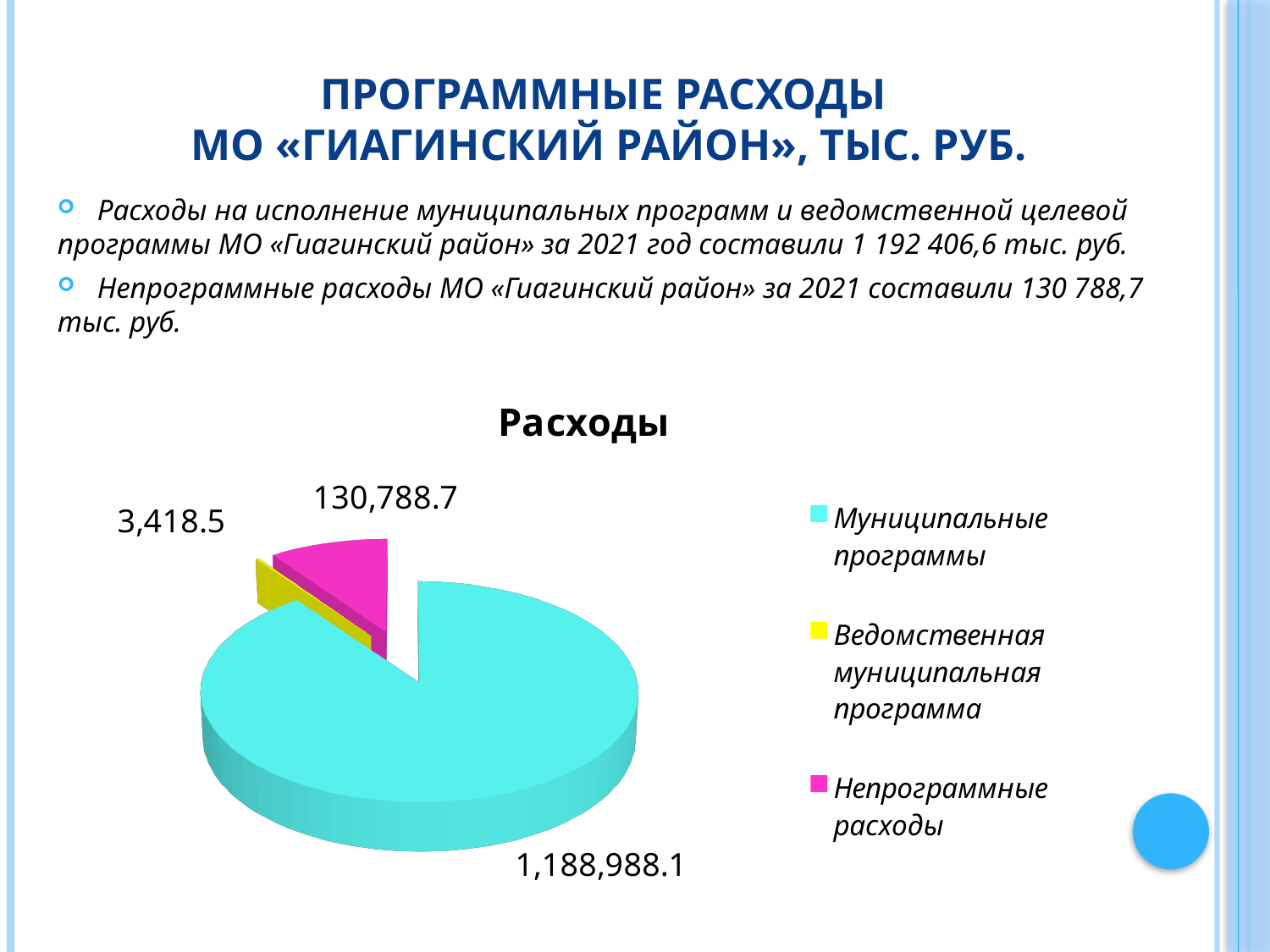
What colour is the slice for Непрограммные расходы? Magenta (pink) What is the value for Ведомственная муниципальная программа? 3,418.5 Which category has the largest slice of the pie? Муниципальные программы What is the difference between the values for Муниципальные программы and Непрограммные расходы? 1,058,199.4 What is the title of the chart? Расходы Which is larger: Непрограммные расходы or Ведомственная муниципальная программа? Непрограммные расходы How many slices does the pie chart have? 3 What type of chart is shown on the slide? Pie chart What is the value for Муниципальные программы? 1,188,988.1 Which category has the smallest slice of the pie? Ведомственная муниципальная программа What is the value for Непрограммные расходы? 130,788.7 What is the difference between the values for Непрограммные расходы and Ведомственная муниципальная программа? 127,370.2